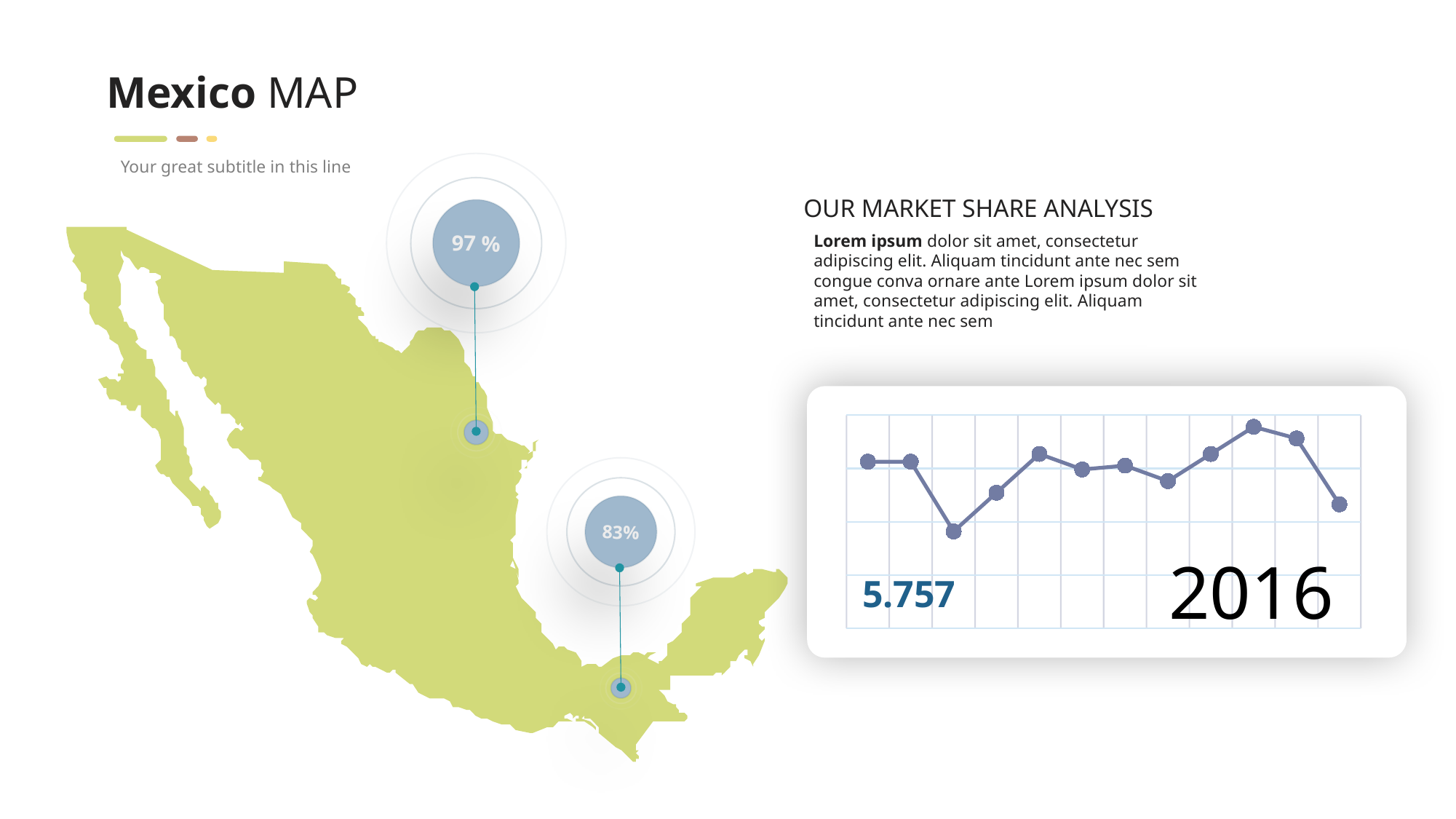
On the line chart, is the last point higher or lower than the first point? lower On the line chart, do the values rise or fall between the tenth point and the last point? fall On the line chart, is the third point higher or lower than the second point? lower How many series are plotted on the line chart? 1 What percentage is shown in the upper marker on the Mexico map? 97 % How many data points are plotted on the line chart? 12 What kind of chart is shown in the market share analysis panel? line chart Which point on the line chart is the lowest? the third point What number is printed in the bottom-left corner of the line chart panel? 5.757 What year is printed on the line chart panel? 2016 What percentage is shown in the lower marker on the Mexico map? 83% Which point on the line chart is the highest? the tenth point